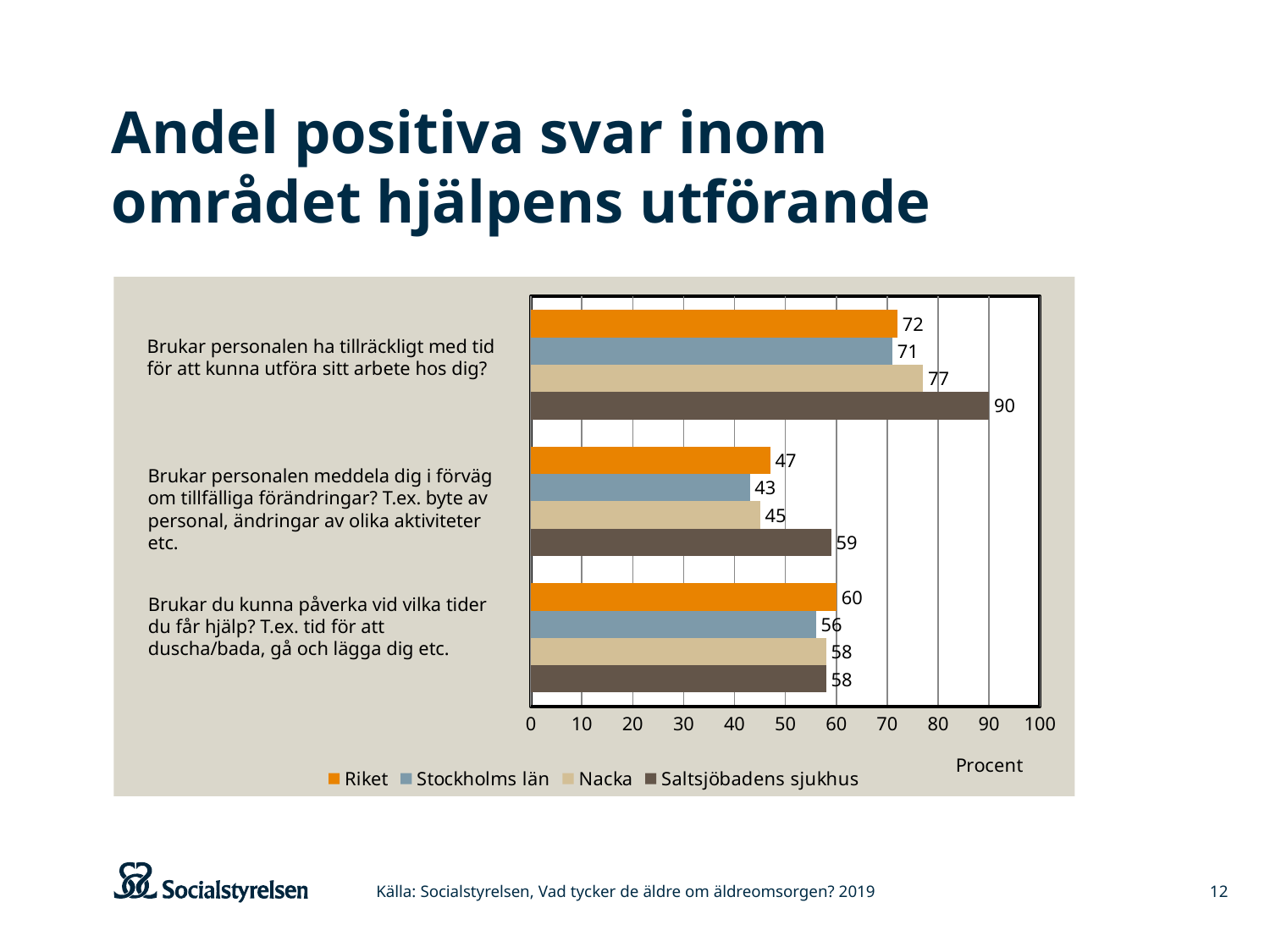
What value does Stockholms län have for "Brukar personalen meddela dig i förväg om tillfälliga förändringar?" 43 What kind of chart is shown on the slide? Bar chart How many question categories are shown on the chart? 3 What value does Riket have for "Brukar du kunna påverka vid vilka tider du får hjälp?" 60 How many series does the legend list? 4 What value does Nacka have for "Brukar personalen ha tillräckligt med tid för att kunna utföra sitt arbete hos dig?" 77 Which series has the lowest value for "Brukar du kunna påverka vid vilka tider du får hjälp?" Stockholms län Is the value for Saltsjöbadens sjukhus on "Brukar personalen meddela dig i förväg om tillfälliga förändringar?" greater or less than 50? greater Which is larger for "Brukar personalen meddela dig i förväg om tillfälliga förändringar?": Riket or Nacka? Riket What value does Saltsjöbadens sjukhus have for "Brukar personalen ha tillräckligt med tid för att kunna utföra sitt arbete hos dig?" 90 Which series has the highest value for "Brukar personalen meddela dig i förväg om tillfälliga förändringar?" Saltsjöbadens sjukhus What is the difference between Saltsjöbadens sjukhus and Riket for "Brukar personalen ha tillräckligt med tid för att kunna utföra sitt arbete hos dig?" 18